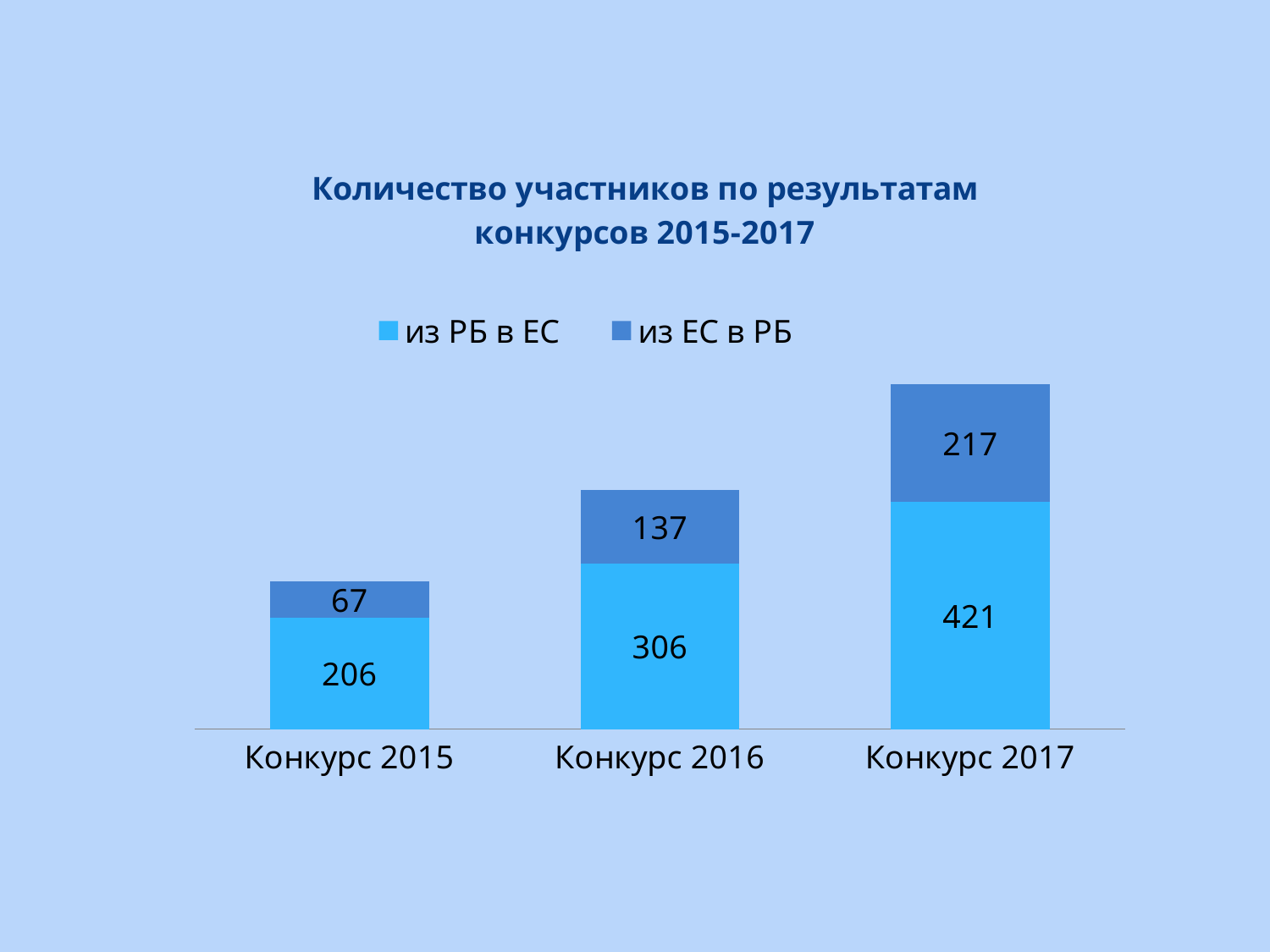
What is the total of the stacked bar for Конкурс 2017? 638 What kind of chart is shown? Stacked bar chart What is the value for "из ЕС в РБ" in Конкурс 2016? 137 What is the total of the stacked bar for Конкурс 2016? 443 Which competition has the lowest value for "из ЕС в РБ"? Конкурс 2015 How many series does the legend list? 2 What is the value for "из РБ в ЕС" in Конкурс 2015? 206 How many competitions (categories) are shown on the x axis? 3 Which is larger: "из ЕС в РБ" in Конкурс 2016 or "из РБ в ЕС" in Конкурс 2015? из РБ в ЕС in Конкурс 2015 Which competition has the highest value for "из РБ в ЕС"? Конкурс 2017 What is the difference between the "из РБ в ЕС" values for Конкурс 2017 and Конкурс 2016? 115 What is the value for "из ЕС в РБ" in Конкурс 2017? 217